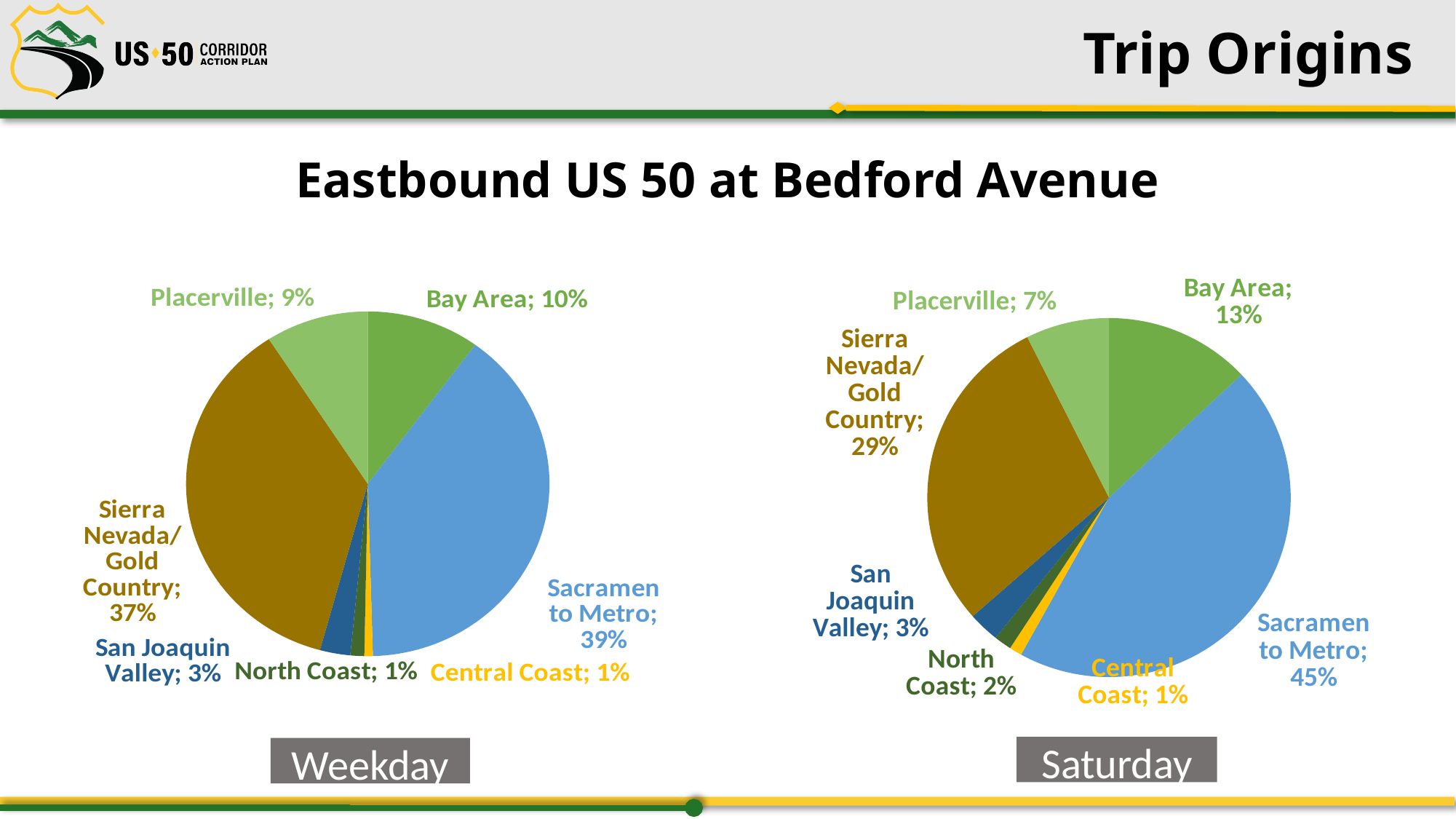
In the Weekday pie chart, what is the difference between the Bay Area share and the Placerville share? 1% In the Saturday pie chart, which origin has the largest share? Sacramento Metro In the Weekday pie chart, which origin has the largest share? Sacramento Metro Which is larger: the Sierra Nevada/Gold Country share on Weekday or on Saturday? Weekday What type of chart is used to show trip origins on this slide? Pie chart Which is larger: the Bay Area share on Weekday or the Bay Area share on Saturday? Saturday What is the title shown above the two pie charts? Eastbound US 50 at Bedford Avenue How many origin categories are shown in the Weekday pie chart? 7 In the Saturday pie chart, what is the difference between the Sacramento Metro share and the Sierra Nevada/Gold Country share? 16% In the Weekday pie chart, what share of trips originate from Sacramento Metro? 39% In the Saturday pie chart, what share of trips originate from Sierra Nevada/Gold Country? 29% In the Saturday pie chart, what share of trips originate from the North Coast? 2%